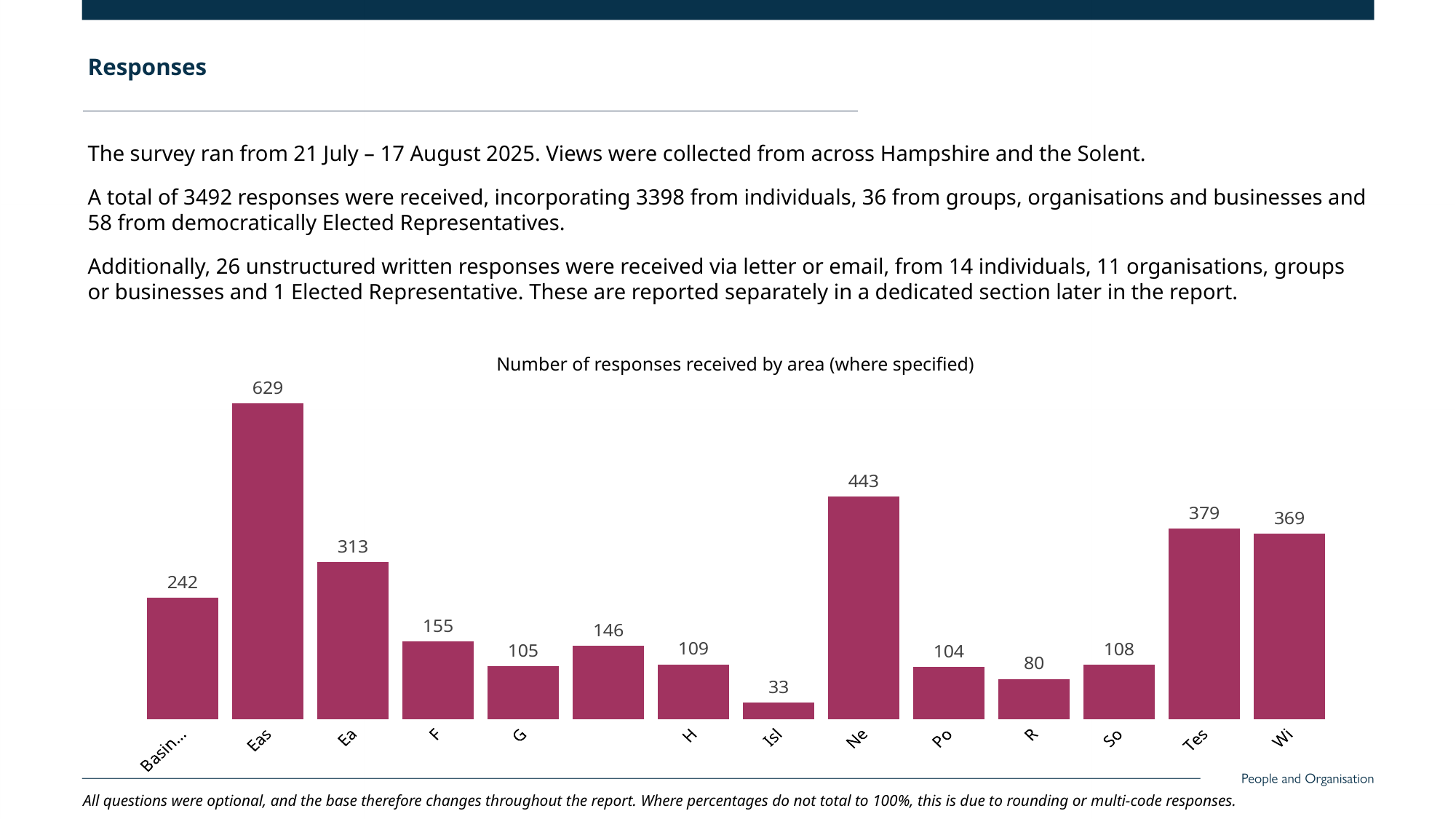
What is the number of responses for the area labelled Ne? 443 Which area has the lowest number of responses in the chart? Isl How many bars are plotted in the chart? 14 Which has more responses, Tes or Wi? Tes What is the number of responses for the area labelled R? 80 What is the difference in responses between Ne and Tes? 64 Which area has the highest number of responses in the chart? Eas What is the difference in responses between Eas and Ea? 316 What is the title of the chart on the slide? Number of responses received by area (where specified) What is the number of responses for the area labelled Tes? 379 What is the number of responses for the area labelled Basin...? 242 What kind of chart is shown on the slide? bar chart